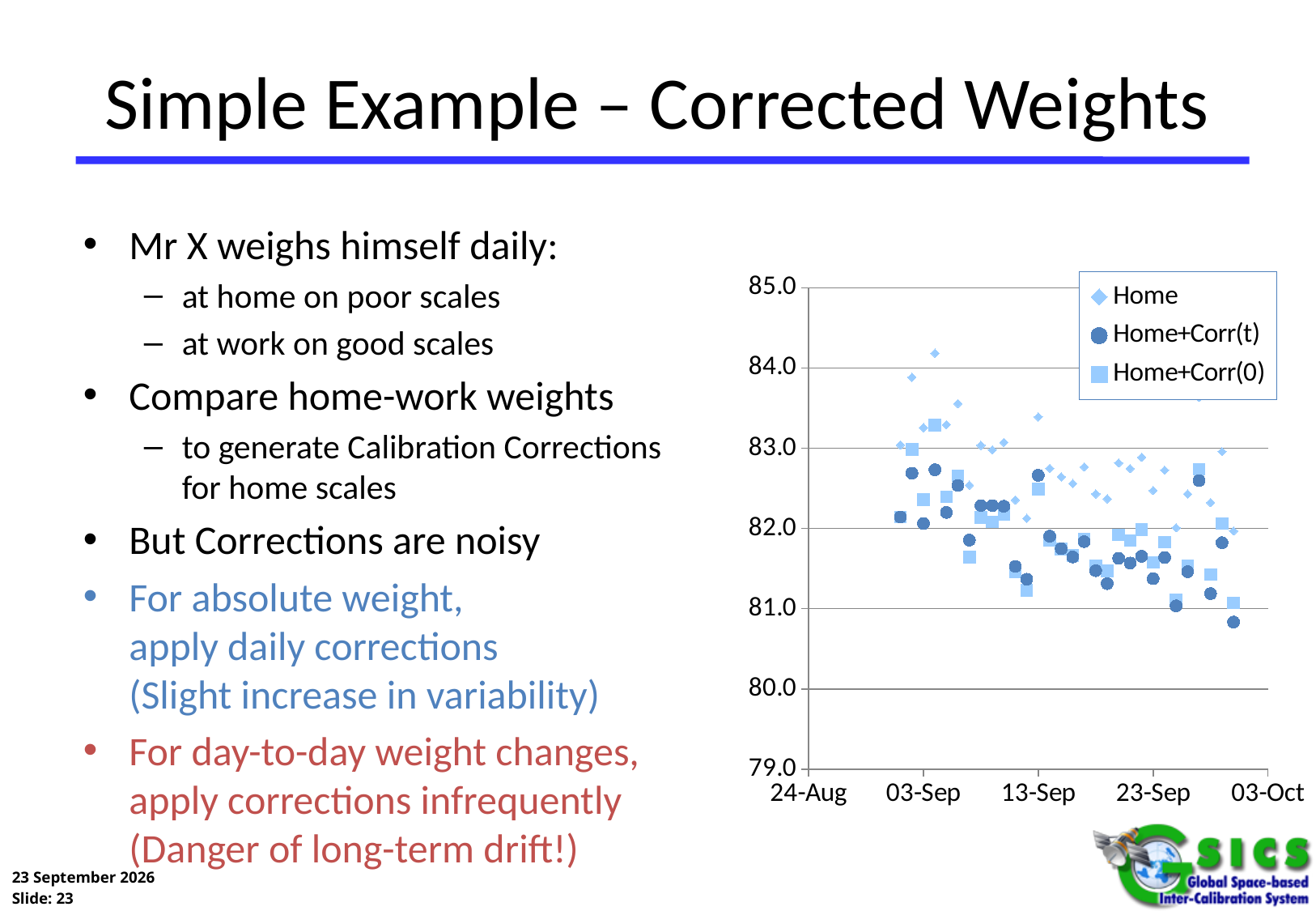
How many date labels are shown on the chart's horizontal axis? 5 What is the last date label on the chart's horizontal axis? 03-Oct What are the three series named in the chart legend? Home, Home+Corr(t), Home+Corr(0) What is the first date label on the chart's horizontal axis? 24-Aug Which marker shape is used for the Home series in the chart? diamond Do the Home+Corr(t) values generally rise or fall from early September to early October? fall How many series does the chart legend list? 3 What is the highest value shown on the chart's vertical axis? 85.0 What kind of chart is shown on the slide? scatter chart Are all the plotted points in the chart greater or less than 80.0? greater Is the lowest Home+Corr(t) point, near 03-Oct, greater or less than 81.0? less What is the lowest value shown on the chart's vertical axis? 79.0